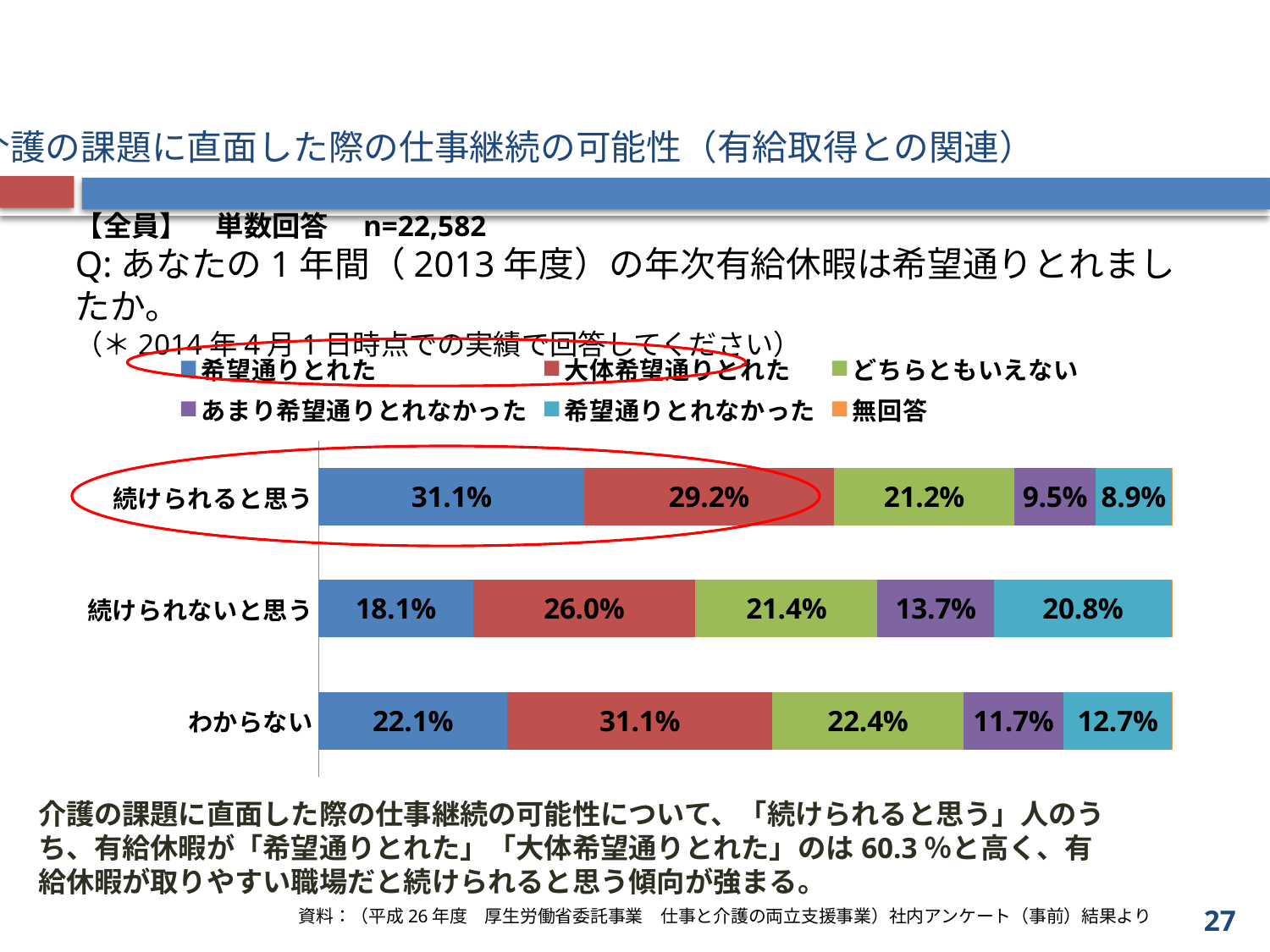
How many series does the legend list? 6 What kind of chart is shown on the slide? Stacked bar chart What is the difference between the 希望通りとれた values for 続けられると思う and 続けられないと思う? 13.0% What is the value of あまり希望通りとれなかった for 続けられると思う? 9.5% How many categories (bars) are plotted in the chart? 3 What is the value of 希望通りとれなかった for わからない? 12.7% Which is larger: the どちらともいえない value for わからない or for 続けられると思う? わからない What is the value of 希望通りとれた for 続けられると思う? 31.1% What is the value of 大体希望通りとれた for 続けられないと思う? 26.0% Which category has the highest value for 希望通りとれた? 続けられると思う Which category has the lowest value for 希望通りとれなかった? 続けられると思う Which legend entry is shown in green? どちらともいえない